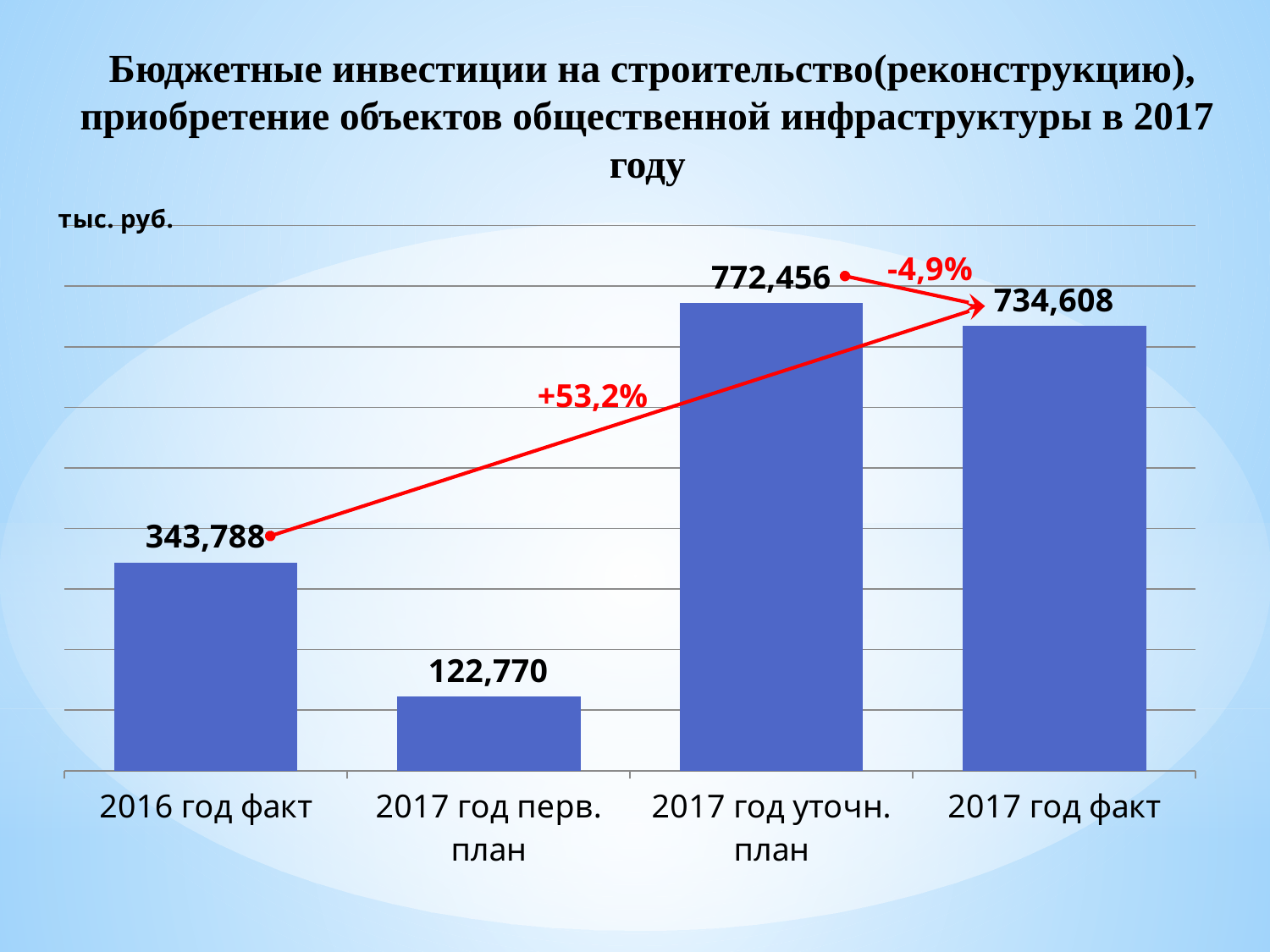
What is the difference between the values for 2017 год уточн. план and 2017 год факт? 37,848 How many categories are shown on the chart? 4 What is the value for 2017 год перв. план? 122,770 What kind of chart is shown on the slide? bar chart What is the difference between the values for 2016 год факт and 2017 год перв. план? 221,018 What is the value for 2017 год уточн. план? 772,456 What unit of measurement is indicated on the chart? тыс. руб. Which category has the highest value? 2017 год уточн. план What is the value for 2016 год факт? 343,788 Which category has the lowest value? 2017 год перв. план Which is larger, the value for 2016 год факт or the value for 2017 год перв. план? 2016 год факт What is the value for 2017 год факт? 734,608